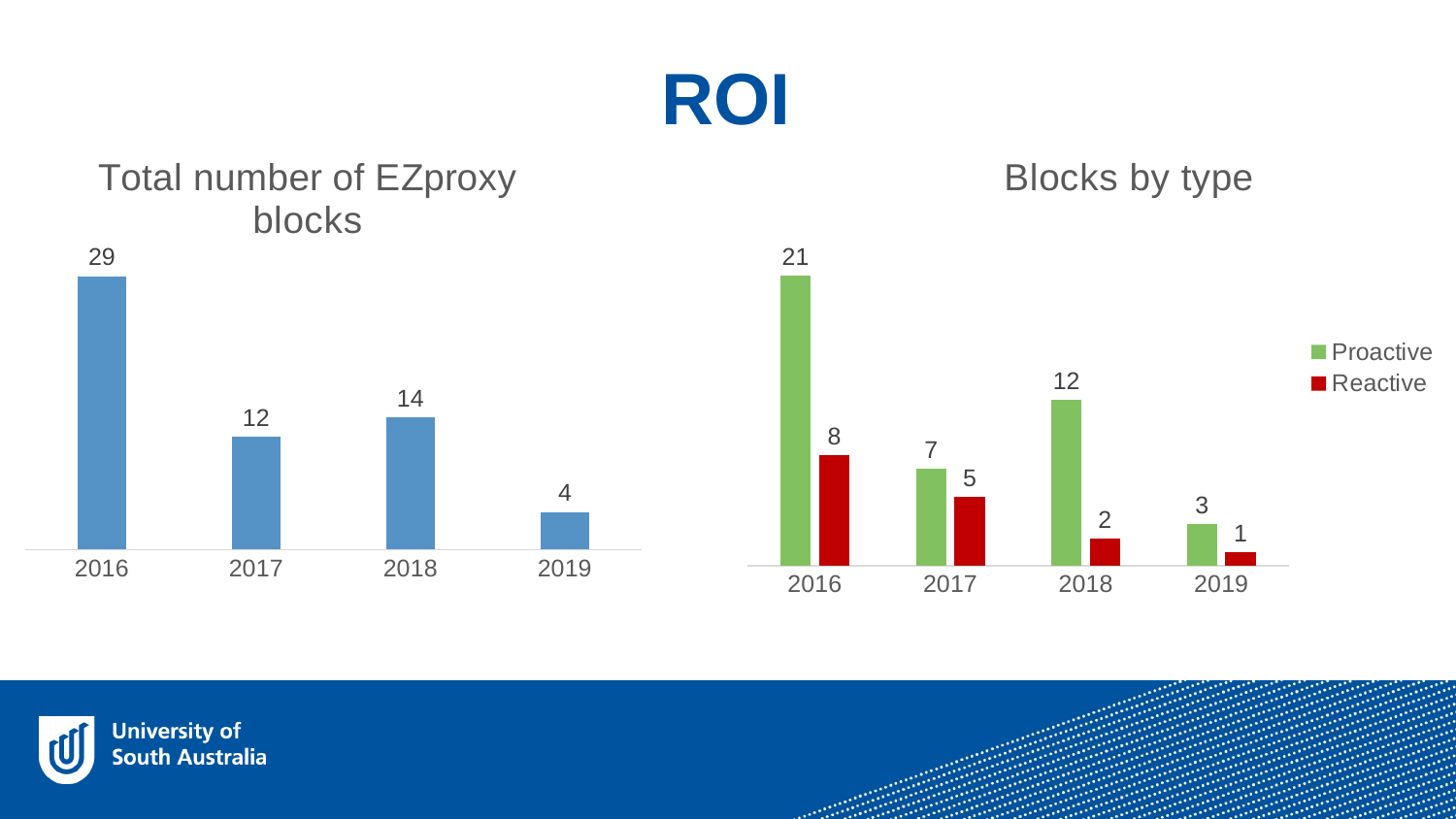
How many series does the legend of the 'Blocks by type' chart list? 2 In the 'Total number of EZproxy blocks' chart, what is the value for 2016? 29 In the 'Blocks by type' chart, what is the Reactive value for 2017? 5 In the 'Blocks by type' chart, which year has the highest Proactive value? 2016 In the 'Total number of EZproxy blocks' chart, how many years are shown on the x axis? 4 In the 'Blocks by type' chart, what is the Proactive value for 2018? 12 What kind of chart is the 'Total number of EZproxy blocks' chart? Bar chart In the 'Blocks by type' chart, do the Reactive values rise or fall from 2016 to 2019? Fall In the 'Total number of EZproxy blocks' chart, what is the difference between the values for 2016 and 2018? 15 In the 'Blocks by type' chart, what is the difference between the Proactive and Reactive values for 2018? 10 In the 'Blocks by type' chart, which is larger for 2016: Proactive or Reactive? Proactive In the 'Total number of EZproxy blocks' chart, which year has the lowest value? 2019